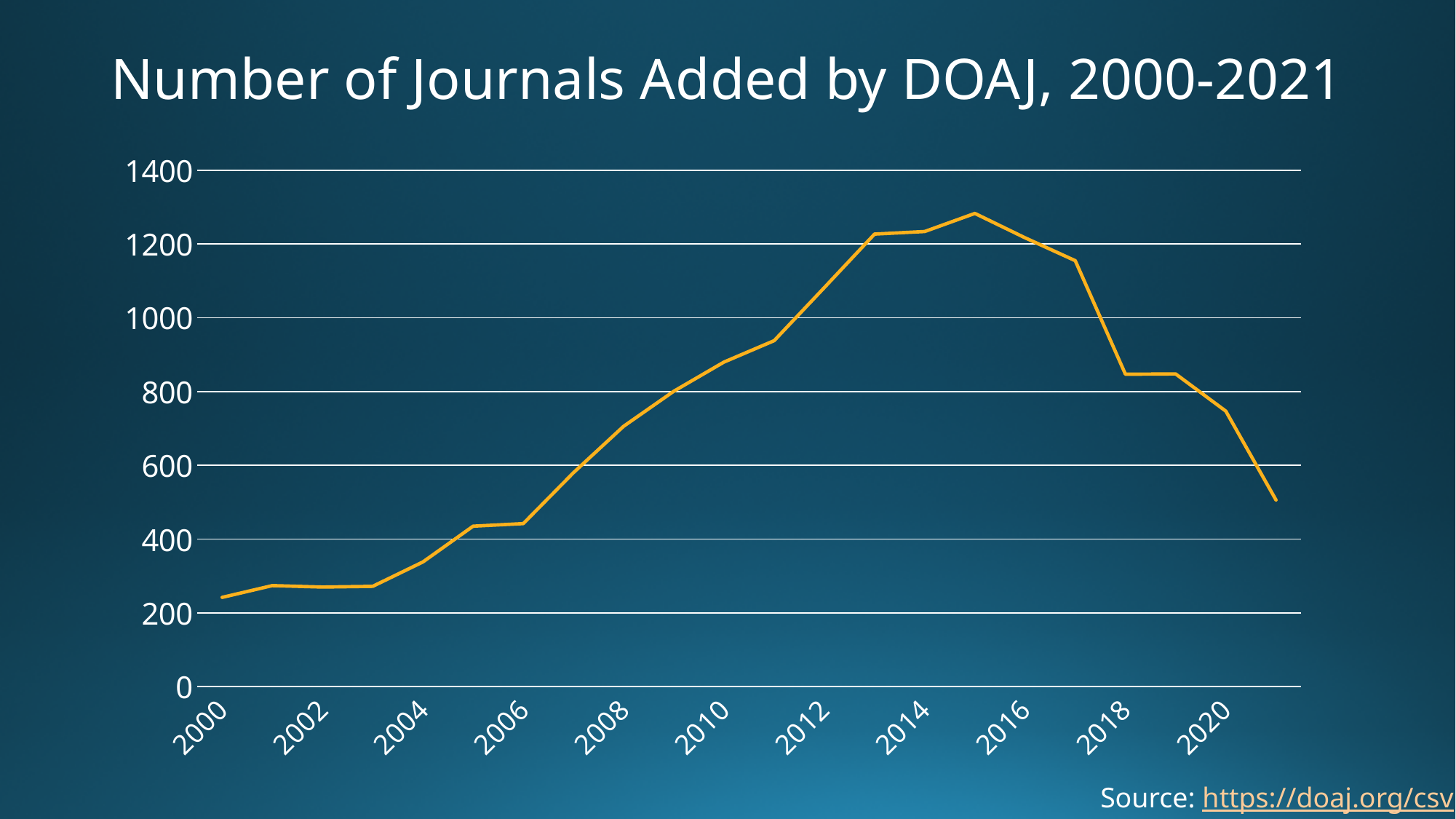
Is the value for 2021 greater or less than 600? less In which year was the number of journals added by DOAJ lowest? 2000 What is the title of the chart? Number of Journals Added by DOAJ, 2000-2021 How many years (data points) are plotted on the chart? 22 What kind of chart is shown on the slide? line chart Which year has the larger value, 2015 or 2021? 2015 Is the value for 2000 greater or less than 400? less Is the value for 2018 greater or less than 1000? less In which year was the number of journals added by DOAJ highest? 2015 Do the values generally rise or fall from 2015 to 2021? fall